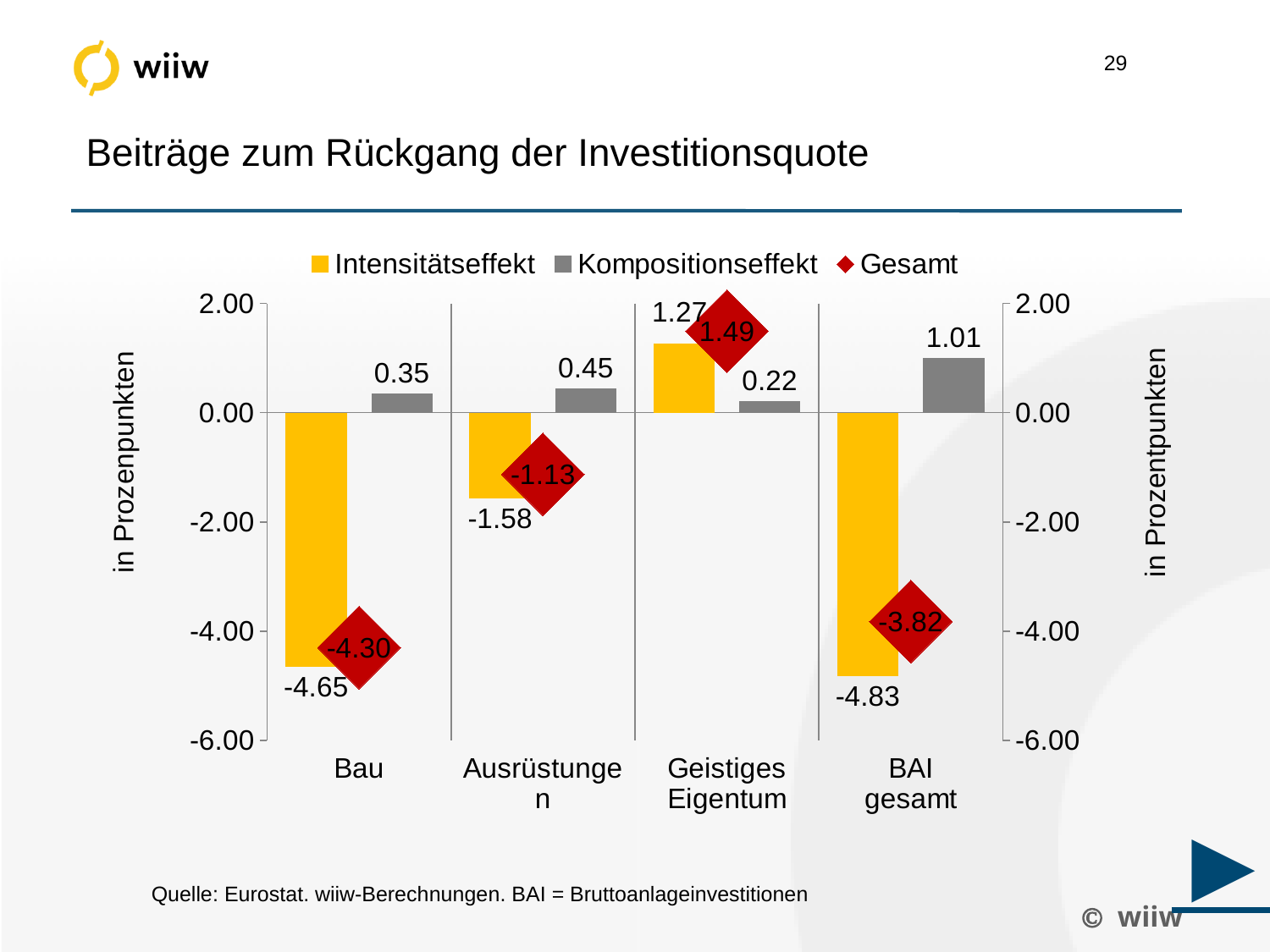
What is the title of the slide? Beiträge zum Rückgang der Investitionsquote What kind of chart is shown on the slide? Bar chart How many categories are shown on the x axis? 4 Which category has the highest Kompositionseffekt value? BAI gesamt What is the Kompositionseffekt value for BAI gesamt? 1.01 How many series does the legend list? 3 What is the Intensitätseffekt value for Bau? -4.65 What is the Gesamt value for Geistiges Eigentum? 1.49 Which category has the lowest Intensitätseffekt value? BAI gesamt Which is larger, the Intensitätseffekt for Geistiges Eigentum or the Kompositionseffekt for Geistiges Eigentum? Intensitätseffekt What is the difference between the Kompositionseffekt values for Ausrüstungen and Bau? 0.10 What is the Gesamt value for Ausrüstungen? -1.13